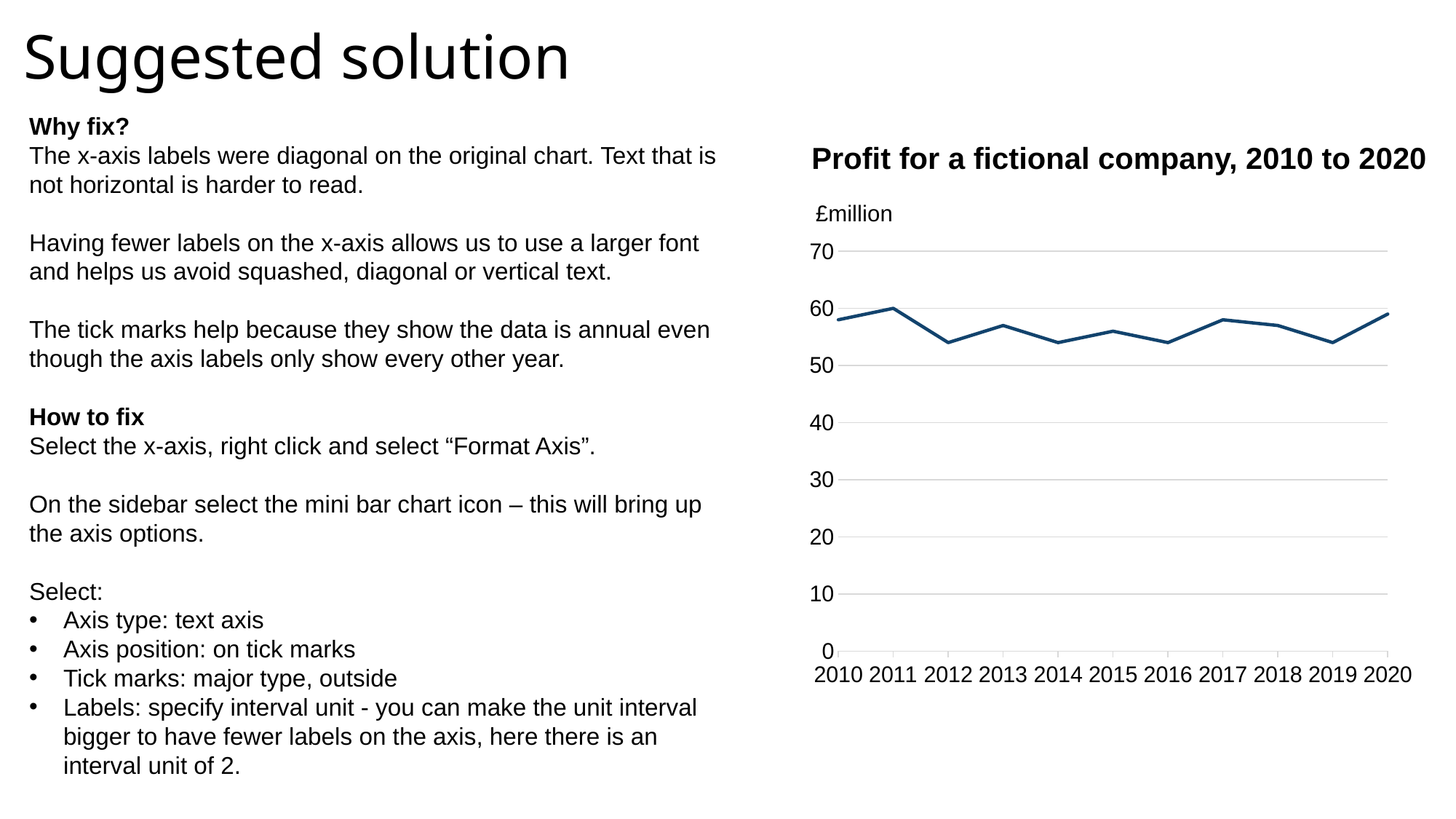
Which year has the larger value, 2011 or 2012? 2011 Is the value for 2019 greater or less than 70? less What is the title of the chart? Profit for a fictional company, 2010 to 2020 Is the value for 2014 greater or less than 40? greater Which year has the larger value, 2017 or 2019? 2017 What kind of chart is shown on the slide? line chart Is the value for 2012 greater or less than 60? less Which year has the larger value, 2019 or 2020? 2020 What unit is shown above the y-axis of the chart? £million How many years are plotted on the chart's x-axis? 11